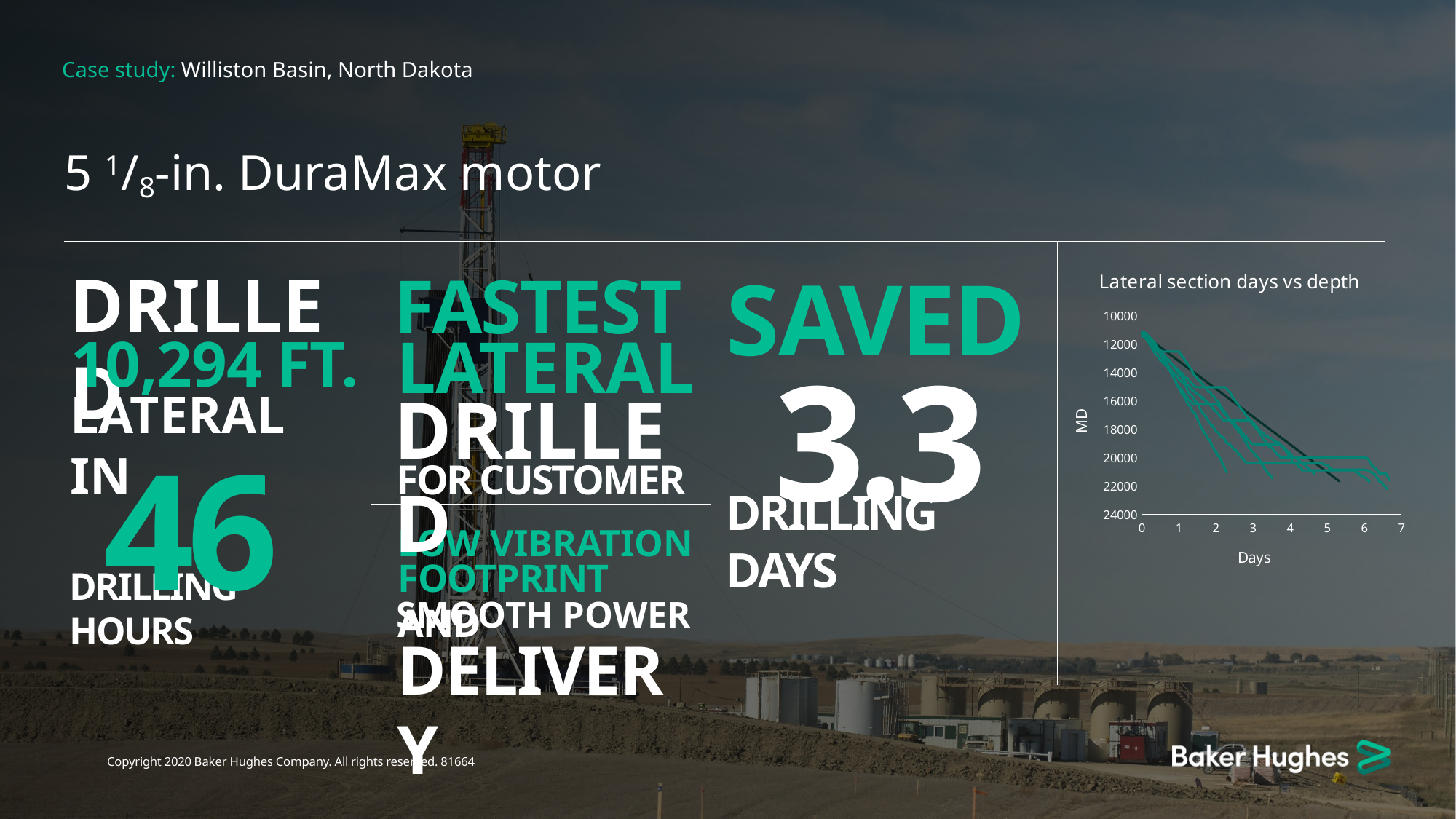
On the 'Lateral section days vs depth' chart, is the MD value of the lines at day 0 greater or less than 14000? less What is the label of the x axis on the 'Lateral section days vs depth' chart? Days On the 'Lateral section days vs depth' chart, is the MD value of the lines at day 6 greater or less than 18000? greater What is the largest value shown on the MD axis of the 'Lateral section days vs depth' chart? 24000 What kind of chart is the 'Lateral section days vs depth' chart? line chart What is the smallest value shown on the MD axis of the 'Lateral section days vs depth' chart? 10000 What is the title of the chart on the right of the slide? Lateral section days vs depth What is the highest day value shown on the x axis of the 'Lateral section days vs depth' chart? 7 How many tick marks are labelled on the x axis of the 'Lateral section days vs depth' chart? 8 On the 'Lateral section days vs depth' chart, does measured depth (MD) increase or decrease as the number of days increases? increase